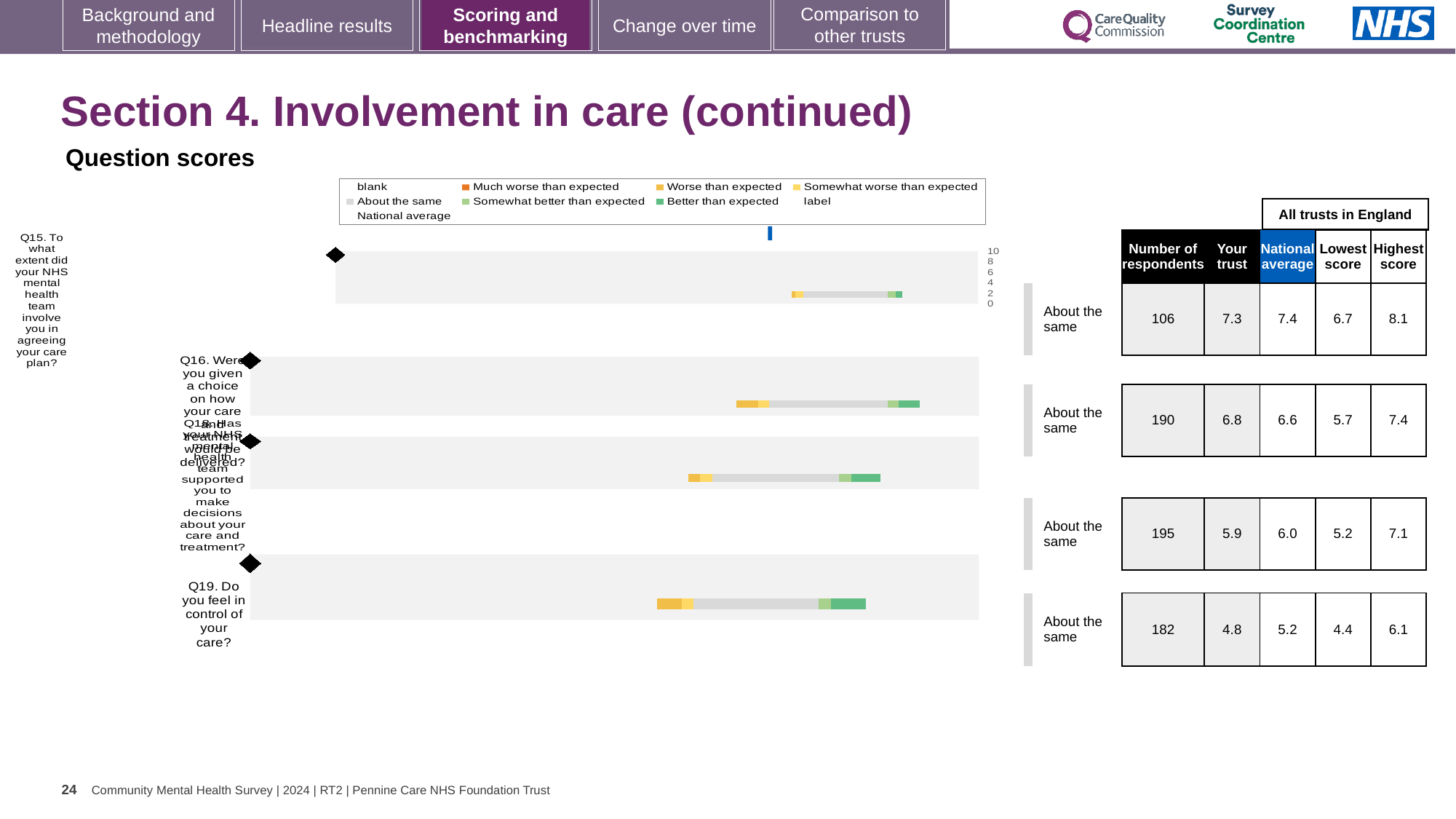
How many respondents answered Q19 (Do you feel in control of your care?)? 182 What is the 'Your trust' score for Q15 (To what extent did your NHS mental health team involve you in agreeing your care plan?)? 7.3 What is the lowest score across all trusts in England for Q19? 4.4 How many questions are plotted on the chart? 4 Which question has the highest 'Your trust' score? Q15 For Q16, which is larger: the 'Your trust' score or the national average? Your trust What is the national average score for Q16 (Were you given a choice on how your care and treatment would be delivered?)? 6.6 Which question has the lowest 'Your trust' score? Q19 What is the highest score across all trusts in England for Q18 (Has your NHS mental health team supported you to make decisions about your care and treatment?)? 7.1 What is the difference between the national average and the 'Your trust' score for Q19? 0.4 What benchmark category is shown for Q15? About the same What kind of chart is used to show the question scores? Bar chart